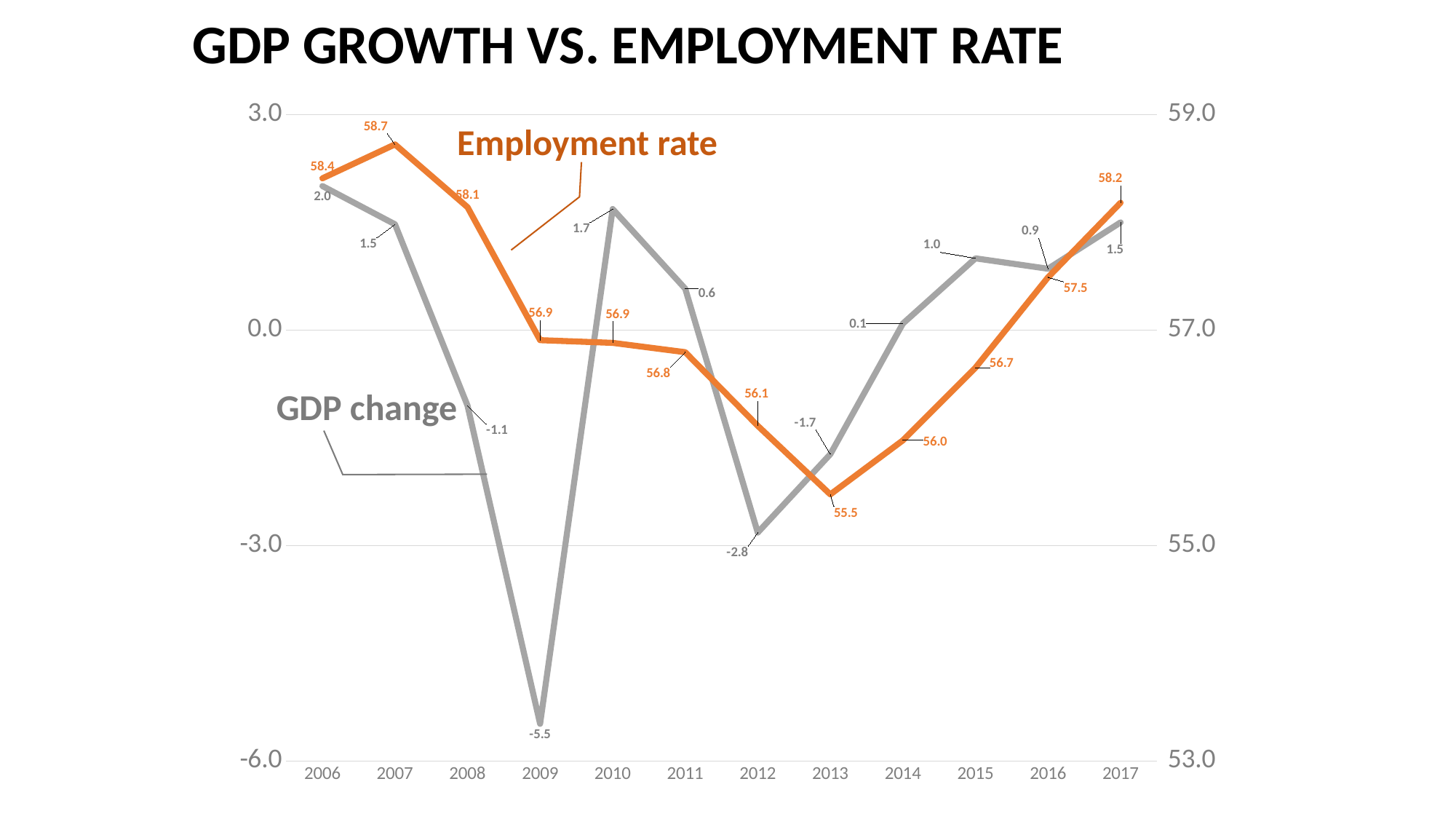
In which year is the employment rate highest? 2007 How many years are plotted on the x axis? 12 What is the GDP change value for 2009? -5.5 What is the employment rate in 2013? 55.5 In which year is the GDP change lowest? 2009 How many data series does the chart show? 2 What is the employment rate in 2017? 58.2 What type of chart is shown on the slide? line chart What is the difference between the employment rate in 2007 and in 2013? 3.2 Which is larger, the GDP change in 2010 or in 2011? 2010 Does the employment rate rise or fall from 2013 to 2017? rise In which year is the GDP change highest? 2006